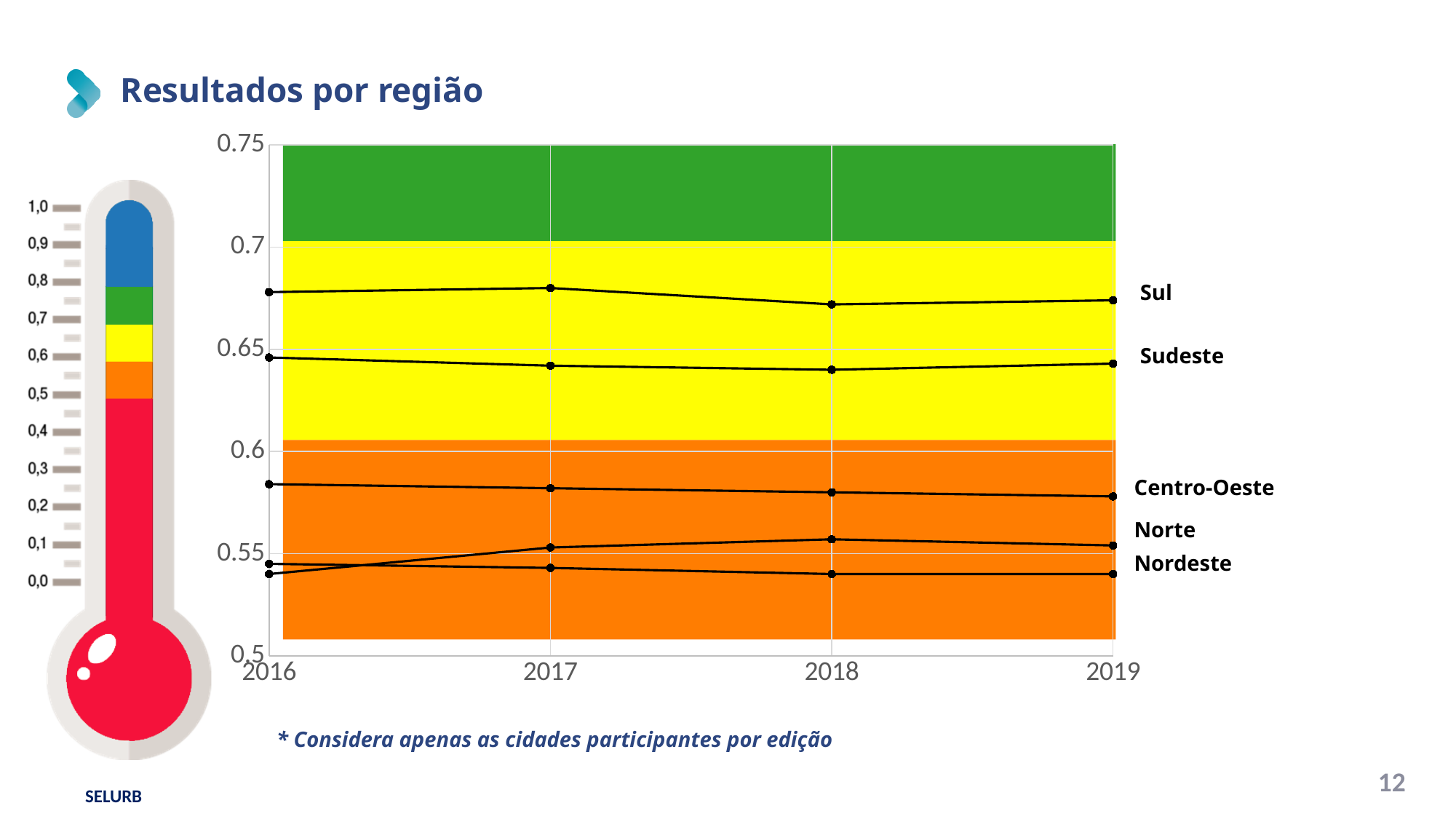
What is the title of the slide containing the chart? Resultados por região Which region has the lowest value in 2019? Nordeste What kind of chart is shown on the slide? line chart How many years are plotted along the x axis of the chart? 4 In 2018, which is larger: the value for Sul or the value for Sudeste? Sul Which region has the highest values across all years in the chart? Sul Is the value for Nordeste in 2018 greater or less than 0.55? less Is the value for Sul in 2018 greater or less than 0.7? less Is the value for Centro-Oeste in 2016 greater or less than 0.6? less Does the Centro-Oeste line rise or fall from 2016 to 2019? fall How many regions (series) are plotted in the chart? 5